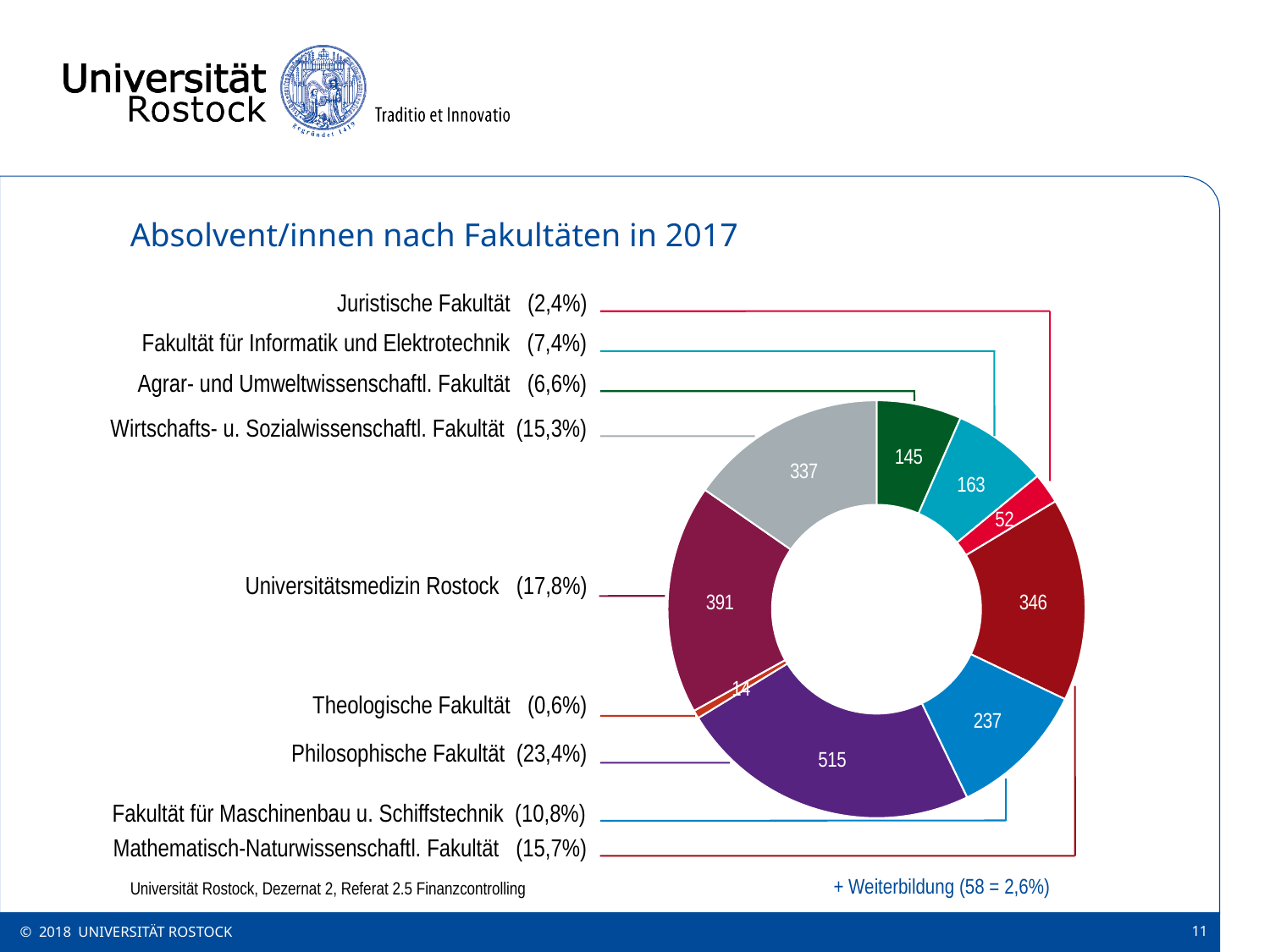
What is the title of the chart? Absolvent/innen nach Fakultäten in 2017 What is the value shown for Universitätsmedizin Rostock? 391 Which faculty has the largest slice in the chart? Philosophische Fakultät What is the value shown for the Fakultät für Maschinenbau u. Schiffstechnik? 237 How many faculties are shown as slices in the chart? 9 What is the difference between the values for the Philosophische Fakultät and Universitätsmedizin Rostock? 124 Which is larger: the value for the Mathematisch-Naturwissenschaftl. Fakultät or the Wirtschafts- u. Sozialwissenschaftl. Fakultät? Mathematisch-Naturwissenschaftl. Fakultät Which faculty has the smallest slice in the chart? Theologische Fakultät What is the value shown for the Juristische Fakultät? 52 What type of chart is shown on the slide? Pie chart (donut) What share of the chart does the Wirtschafts- u. Sozialwissenschaftl. Fakultät represent? 15,3% How many graduates does the chart show for the Philosophische Fakultät? 515